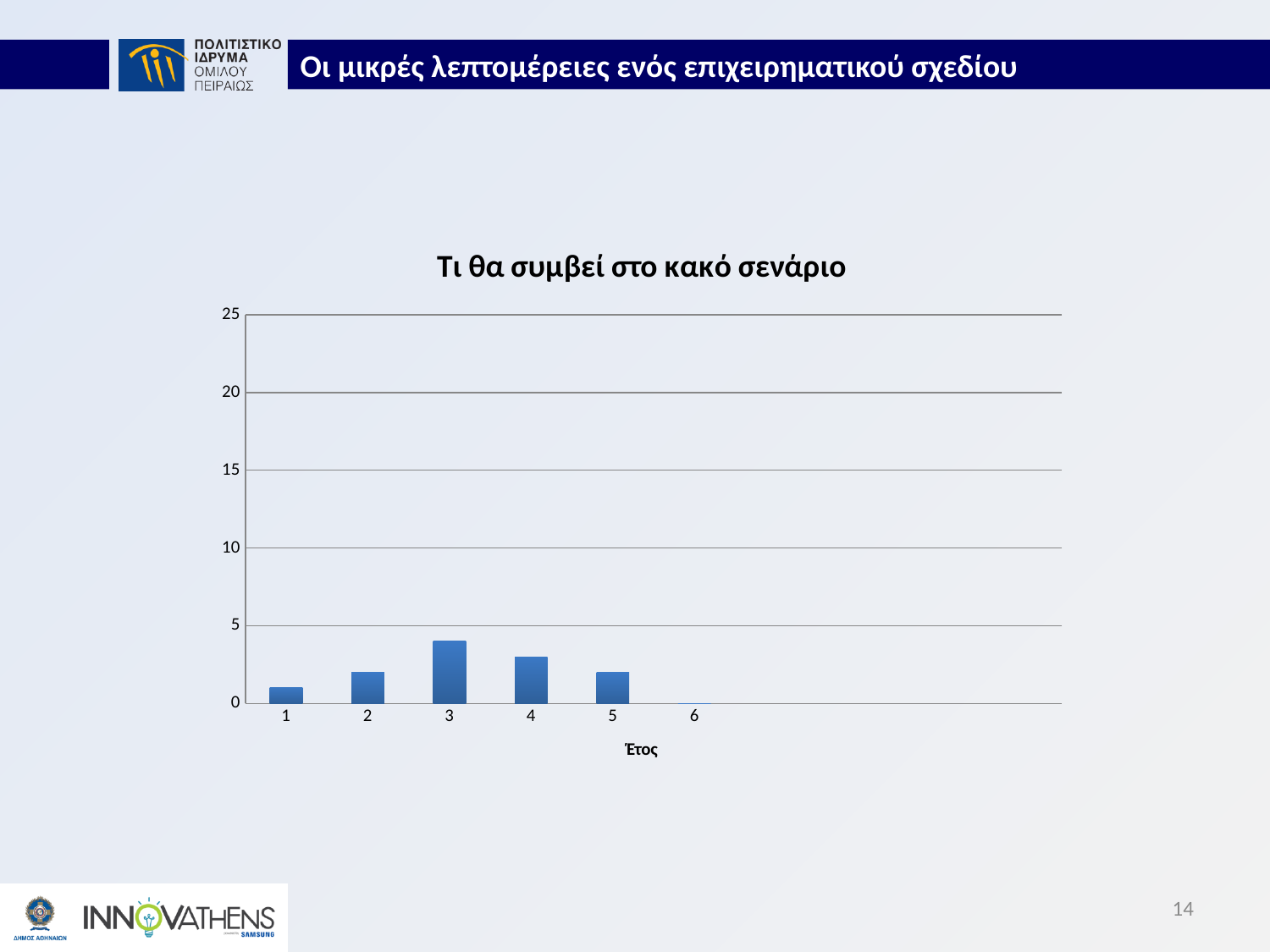
Which is larger, the value for year 3 or the value for year 1? Year 3 Do the values rise or fall from year 3 to year 5? Fall What is the label of the x axis? Έτος How many categories are shown on the x axis? 6 Do the values rise or fall from year 1 to year 3? Rise What is the highest value shown on the y axis? 25 What type of chart is shown on the slide? Bar chart Which year has the tallest bar? 3 Is the value for year 1 greater or less than 5? less Which is larger, the value for year 4 or the value for year 2? Year 4 What is the title of the chart? Τι θα συμβεί στο κακό σενάριο Is the value for year 3 greater or less than 5? less